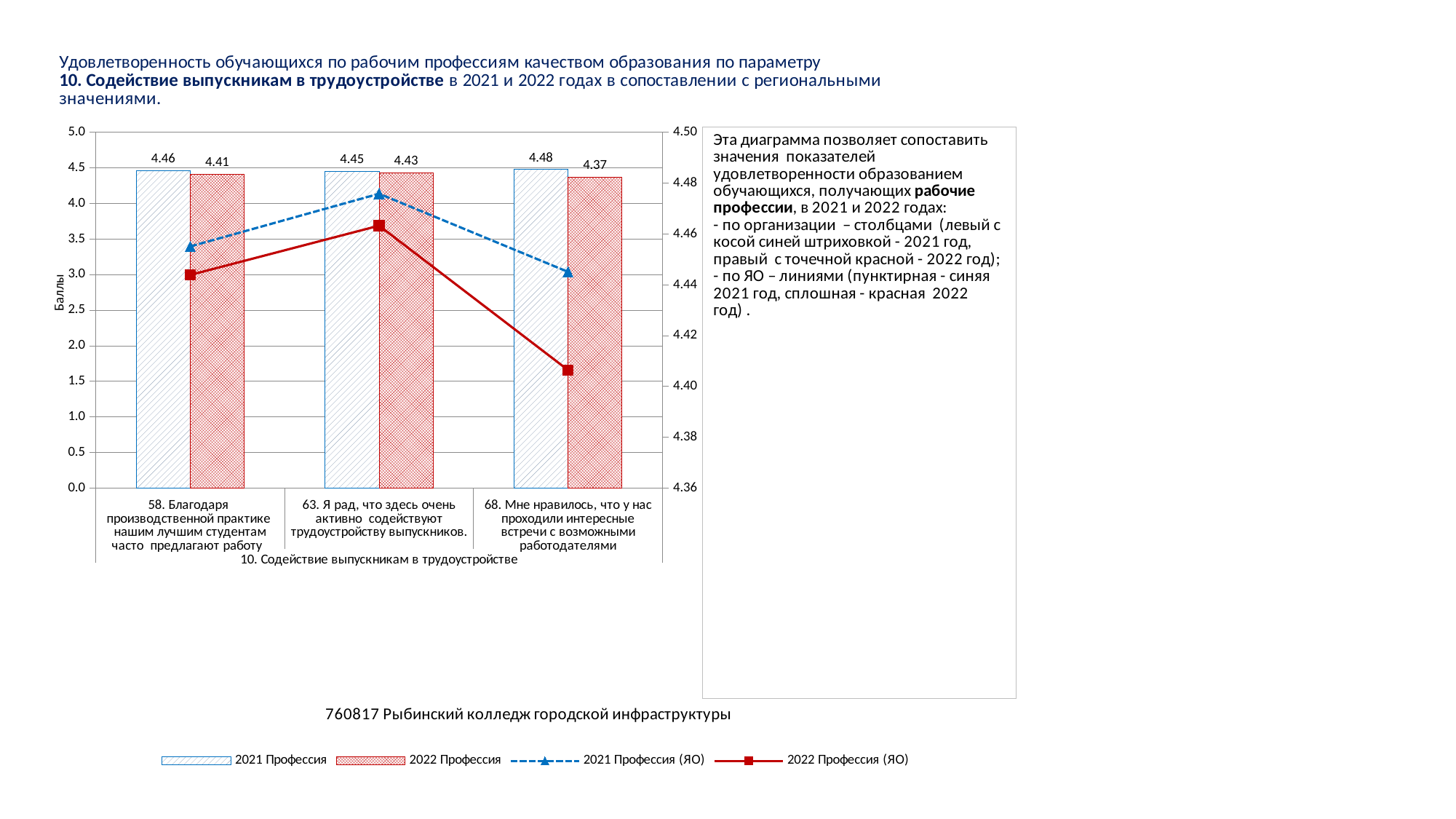
Does the 2022 Профессия (ЯО) line rise or fall from category 63 to category 68? fall What is the value of the 2022 Профессия bar for category 63 (Я рад, что здесь очень активно содействуют трудоустройству выпускников)? 4.43 For category 58, which bar is larger: 2021 Профессия or 2022 Профессия? 2021 Профессия What is the value of the 2022 Профессия bar for category 68 (Мне нравилось, что у нас проходили интересные встречи с возможными работодателями)? 4.37 Which category has the lowest 2022 Профессия bar? 68. Мне нравилось, что у нас проходили интересные встречи с возможными работодателями How many series does the legend list? 4 What is the value of the 2021 Профессия bar for category 58 (Благодаря производственной практике нашим лучшим студентам часто предлагают работу)? 4.46 What is the difference between the 2021 Профессия and 2022 Профессия bars for category 68? 0.11 What kind of chart is shown on the slide? bar chart with line series On the right-hand axis, is the value of the 2022 Профессия (ЯО) line for category 68 greater or less than 4.42? less Which category has the highest 2021 Профессия bar? 68. Мне нравилось, что у нас проходили интересные встречи с возможными работодателями How many categories are shown on the x axis? 3